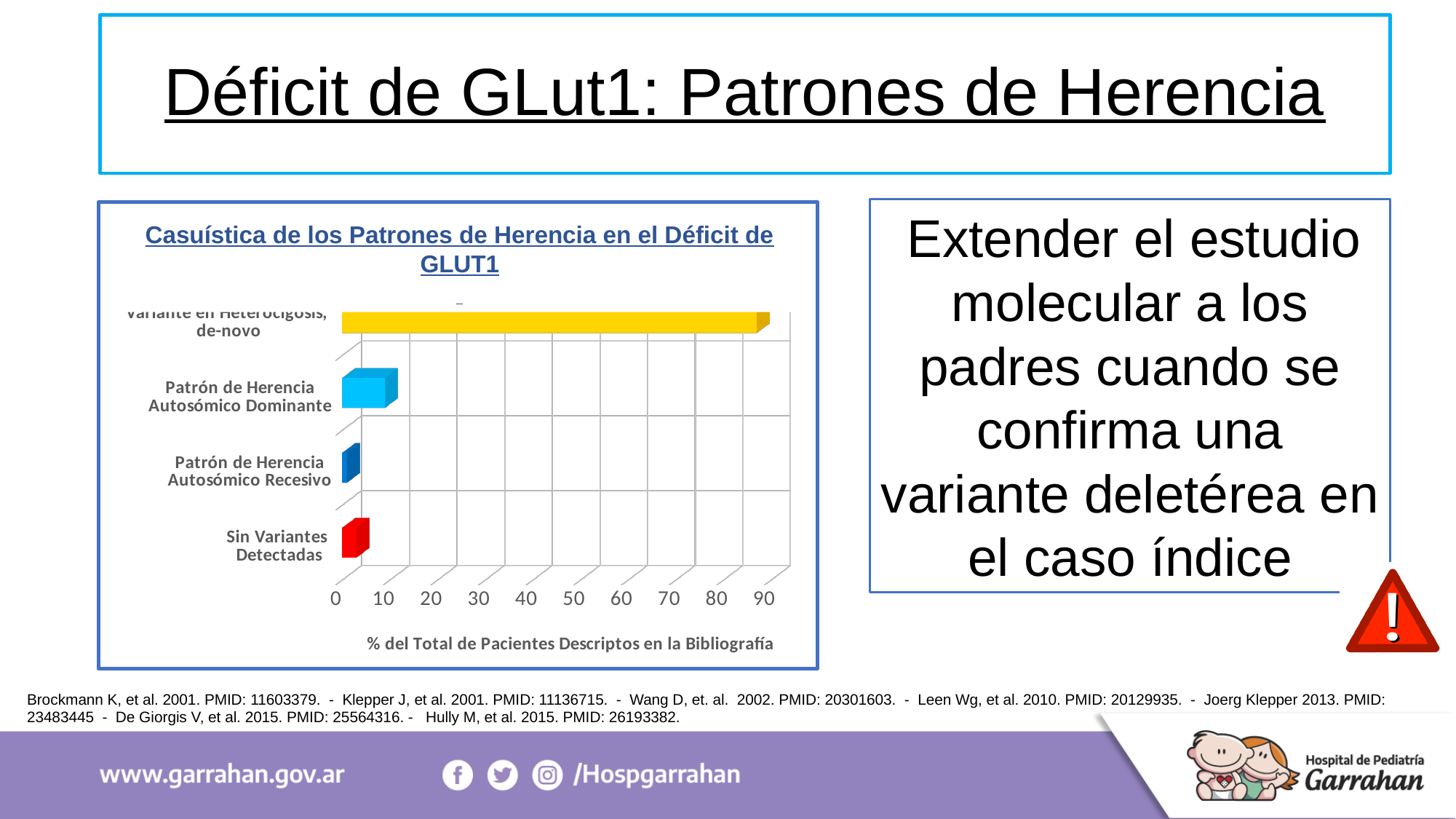
Which is larger, the value for Patrón de Herencia Autosómico Dominante or for Patrón de Herencia Autosómico Recesivo? Patrón de Herencia Autosómico Dominante Is the value for Patrón de Herencia Autosómico Dominante greater or less than 20? less Is the value for Sin Variantes Detectadas greater or less than 10? less What is the label of the horizontal axis of the chart? % del Total de Pacientes Descriptos en la Bibliografía Which is larger, the value for Variante en Heterocigosis, de-novo or for Sin Variantes Detectadas? Variante en Heterocigosis, de-novo What kind of chart is shown on the slide? bar chart Is the value for Patrón de Herencia Autosómico Recesivo greater or less than 10? less Which category has the highest value in the chart? Variante en Heterocigosis, de-novo How many categories are plotted in the chart? 4 What is the title of the chart? Casuística de los Patrones de Herencia en el Déficit de GLUT1